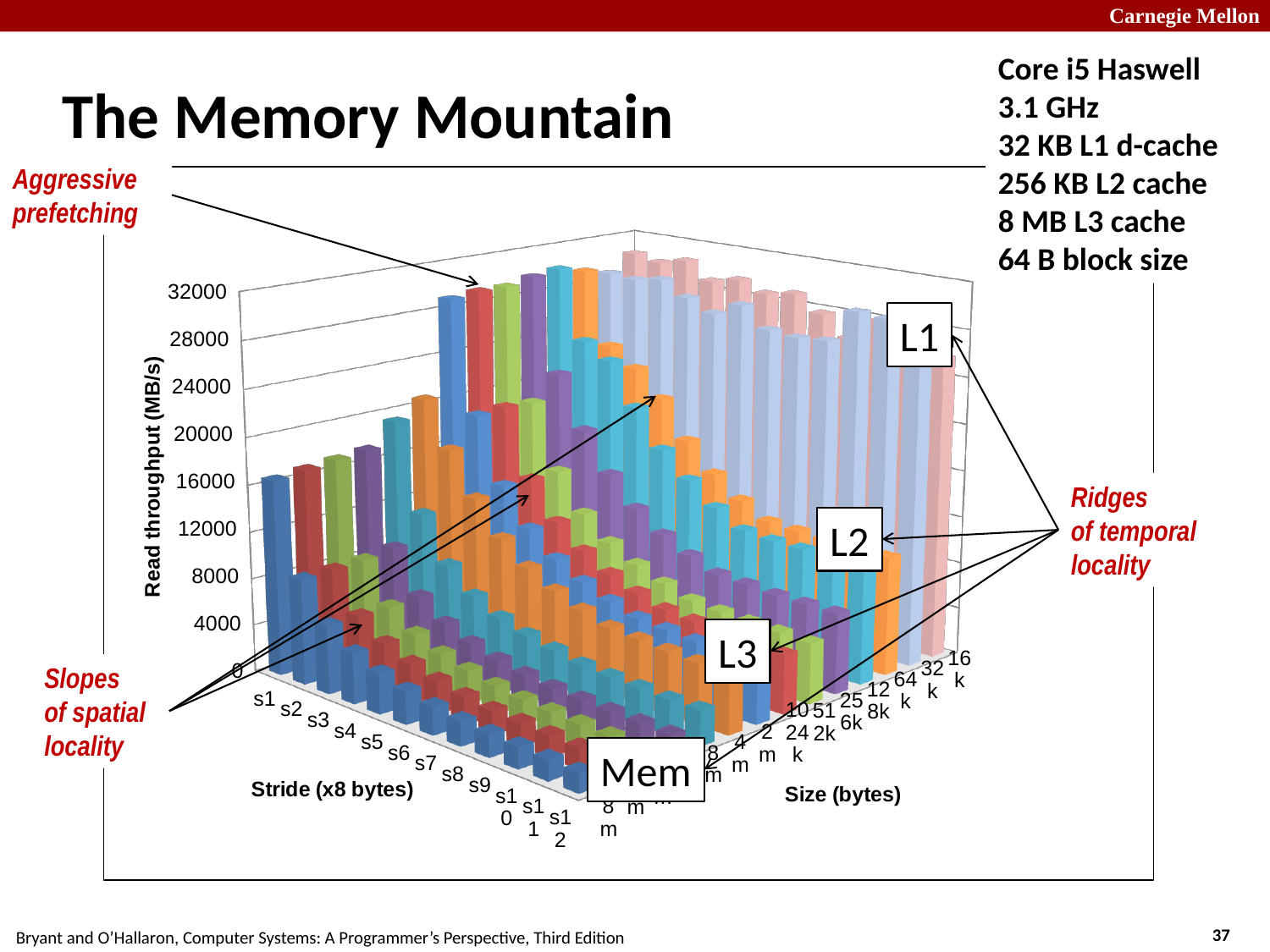
What is the highest tick value shown on the Read throughput axis? 32000 Is the tallest bar in the chart greater or less than 20000 MB/s? greater What kind of chart is shown on the slide? bar chart How many stride categories (s1 through s12) are shown along the Stride axis? 12 For a given size, does read throughput rise or fall as the stride increases from s1 to s12? fall What is the title of the vertical axis of the chart? Read throughput (MB/s)